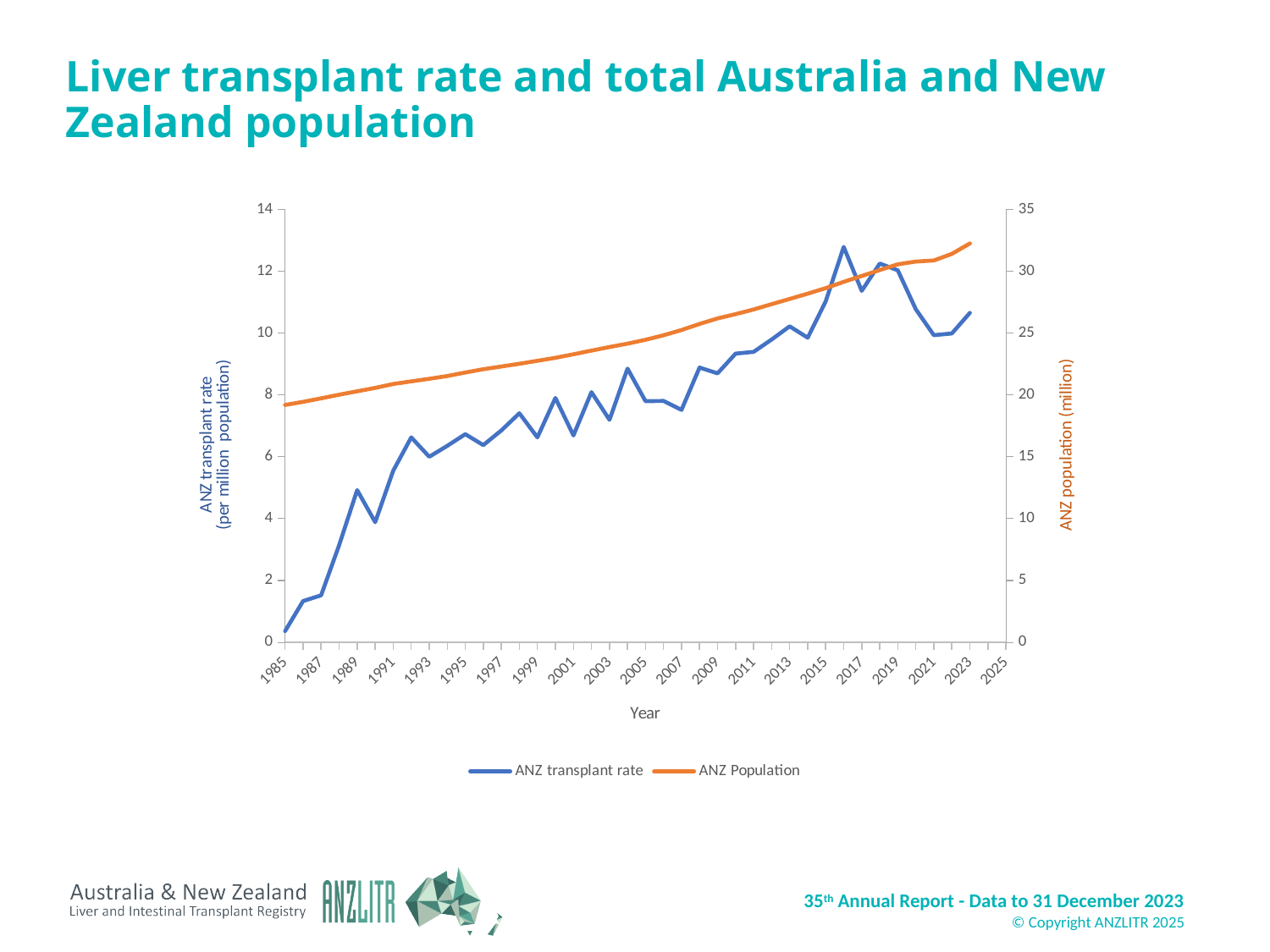
Is the ANZ population in 2013 greater or less than 25 million? greater In which year is the ANZ transplant rate at its lowest? 1985 What kind of chart is shown on the slide? Line chart Does the ANZ Population line rise or fall from 1985 to 2023? Rises How many series does the legend list? 2 What is the title of the right-hand vertical axis? ANZ population (million) What are the two series named in the legend? ANZ transplant rate and ANZ Population Is the ANZ transplant rate in 1990 greater or less than 6 per million population? less Is the ANZ transplant rate in 2016 greater or less than 12 per million population? greater In which year does the ANZ transplant rate reach its highest value? 2016 Which year has the higher ANZ transplant rate, 2016 or 2023? 2016